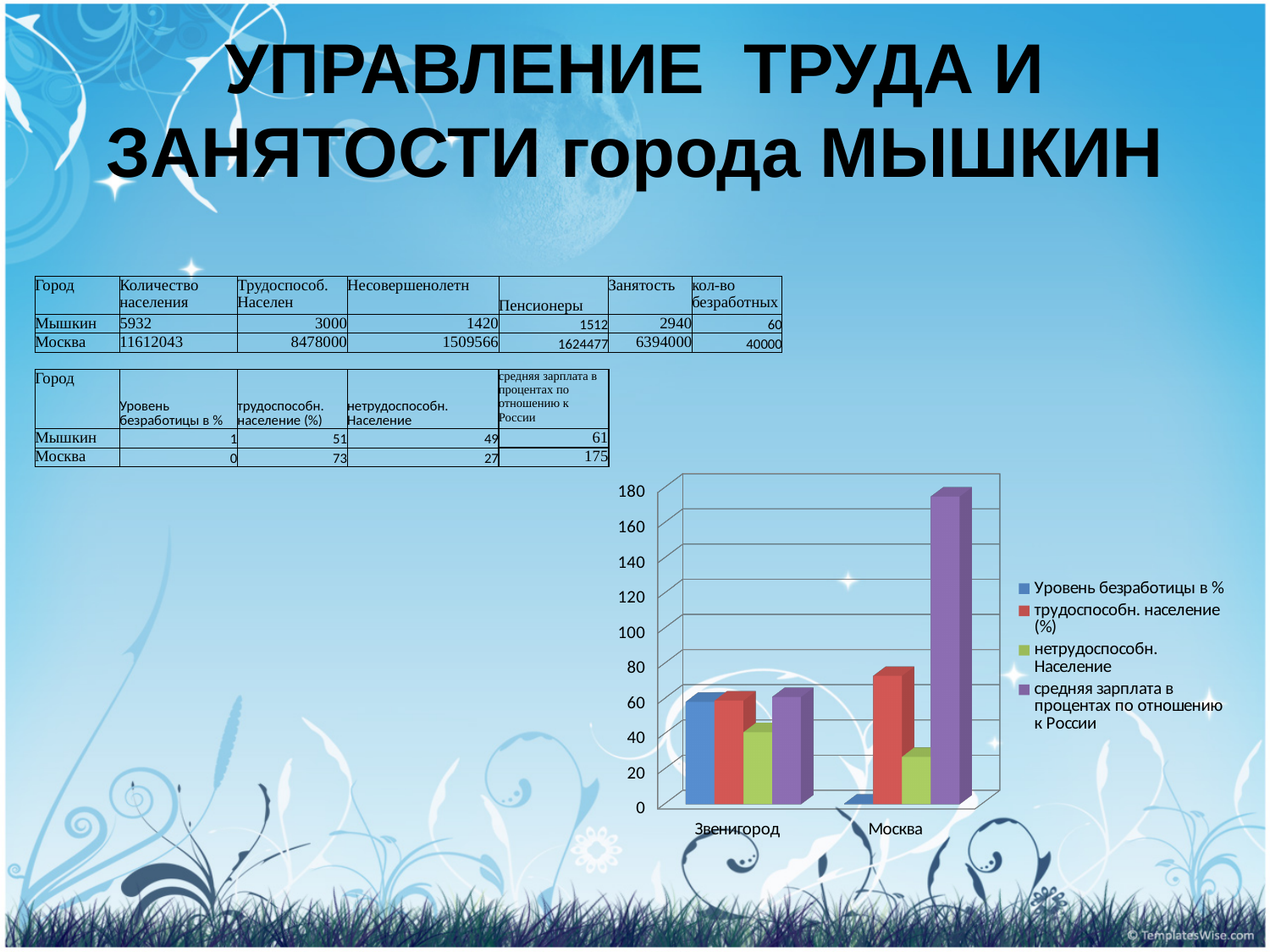
Which series has the smallest bar for Москва? Уровень безработицы в % Which category has the larger value for 'средняя зарплата в процентах по отношению к России', Звенигород or Москва? Москва What colour represents the series 'средняя зарплата в процентах по отношению к России' in the chart? purple How many series does the chart legend list? 4 Is the value of 'средняя зарплата в процентах по отношению к России' for Москва greater or less than 160? greater Is the value of 'трудоспособн. население (%)' for Москва greater or less than 60? greater Which series has the tallest bar for Москва? средняя зарплата в процентах по отношению к России Which category has the larger value for 'нетрудоспособн. Население', Звенигород or Москва? Звенигород Is the value of 'нетрудоспособн. Население' for Москва greater or less than 40? less What kind of chart is shown on the slide? bar chart How many categories are shown on the x axis of the chart? 2 Which category has the tallest bar in the chart? Москва